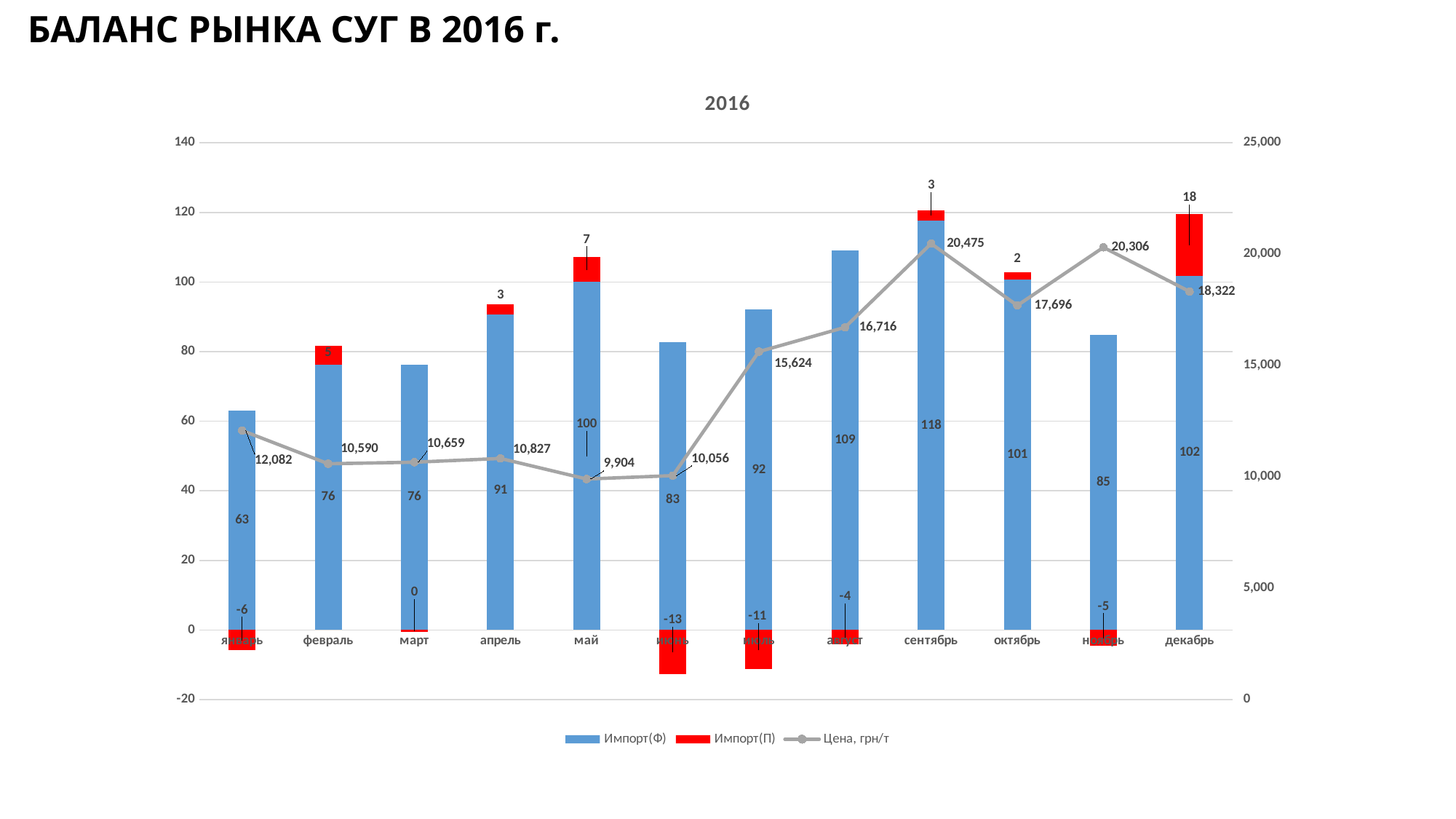
What is the difference between the Импорт(Ф) values for сентябрь and январь? 55 How many months are shown on the x axis? 12 Which month has the highest Цена, грн/т value? сентябрь What is the total of the stacked bar for май (Импорт(Ф) plus Импорт(П))? 107 What is the Импорт(П) value for декабрь? 18 Which is larger, the Импорт(Ф) value for август or for октябрь? август Which month has the highest Импорт(Ф) value? сентябрь What is the Импорт(Ф) value for сентябрь? 118 Which month has the lowest Импорт(П) value? июнь What is the Цена, грн/т value for май? 9,904 What is the title shown above the chart? 2016 How many series does the legend list? 3